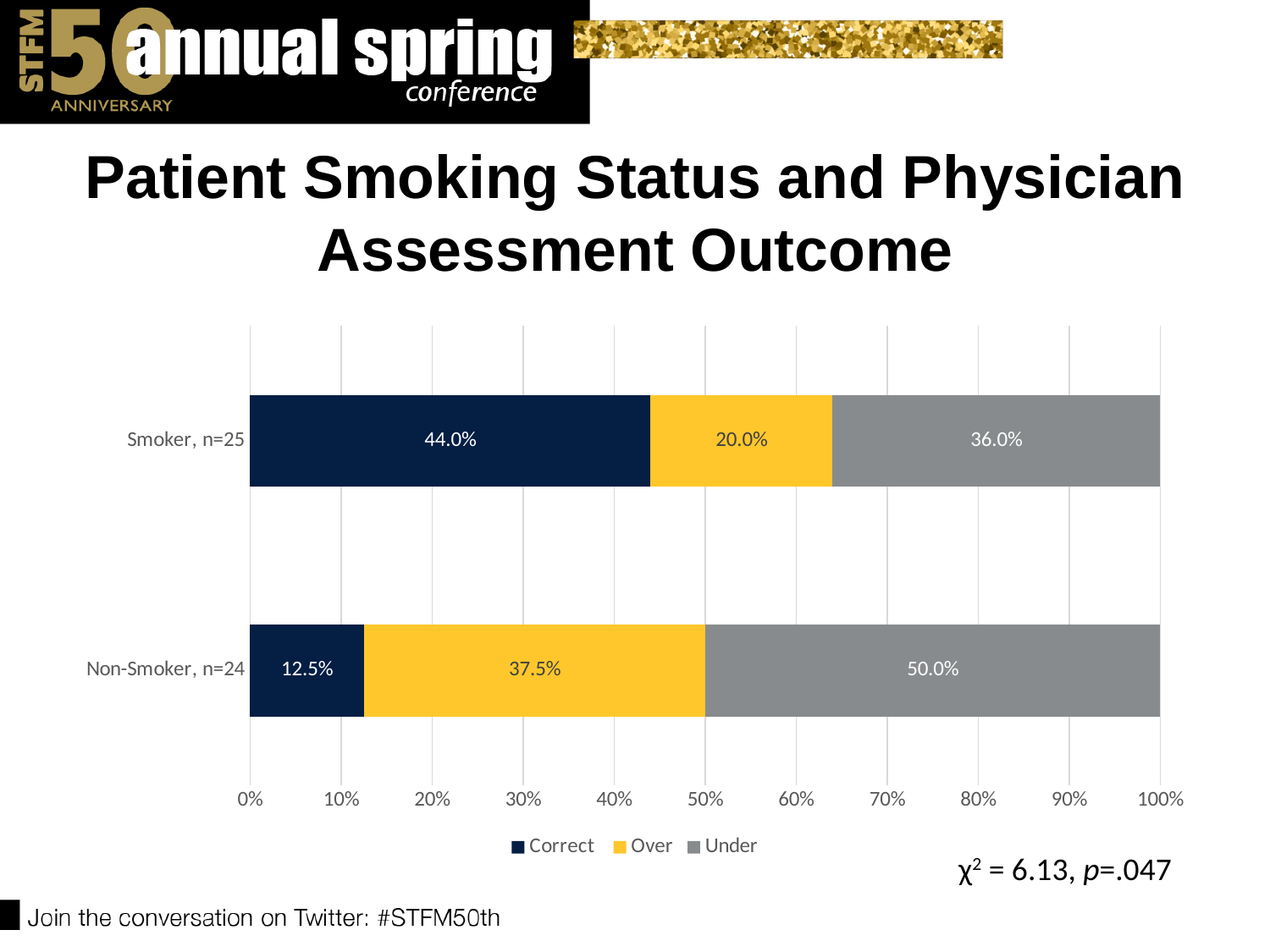
What kind of chart is shown on the slide? Stacked bar chart Which category has the lower Over percentage? Smoker, n=25 What percentage of smokers (n=25) were assessed correctly? 44.0% What is the difference between the Correct percentages for smokers and non-smokers? 31.5% Which category has the higher Correct percentage, Smoker or Non-Smoker? Smoker, n=25 How many series does the legend list? 3 What percentage of non-smokers (n=24) were under-assessed? 50.0% What is the Under value for the Smoker, n=25 category? 36.0% How many categories are shown on the chart? 2 Which colour represents the Over series in the legend? Yellow What is the difference between the Under percentages for non-smokers and smokers? 14.0% What is the Over value for the Non-Smoker, n=24 category? 37.5%